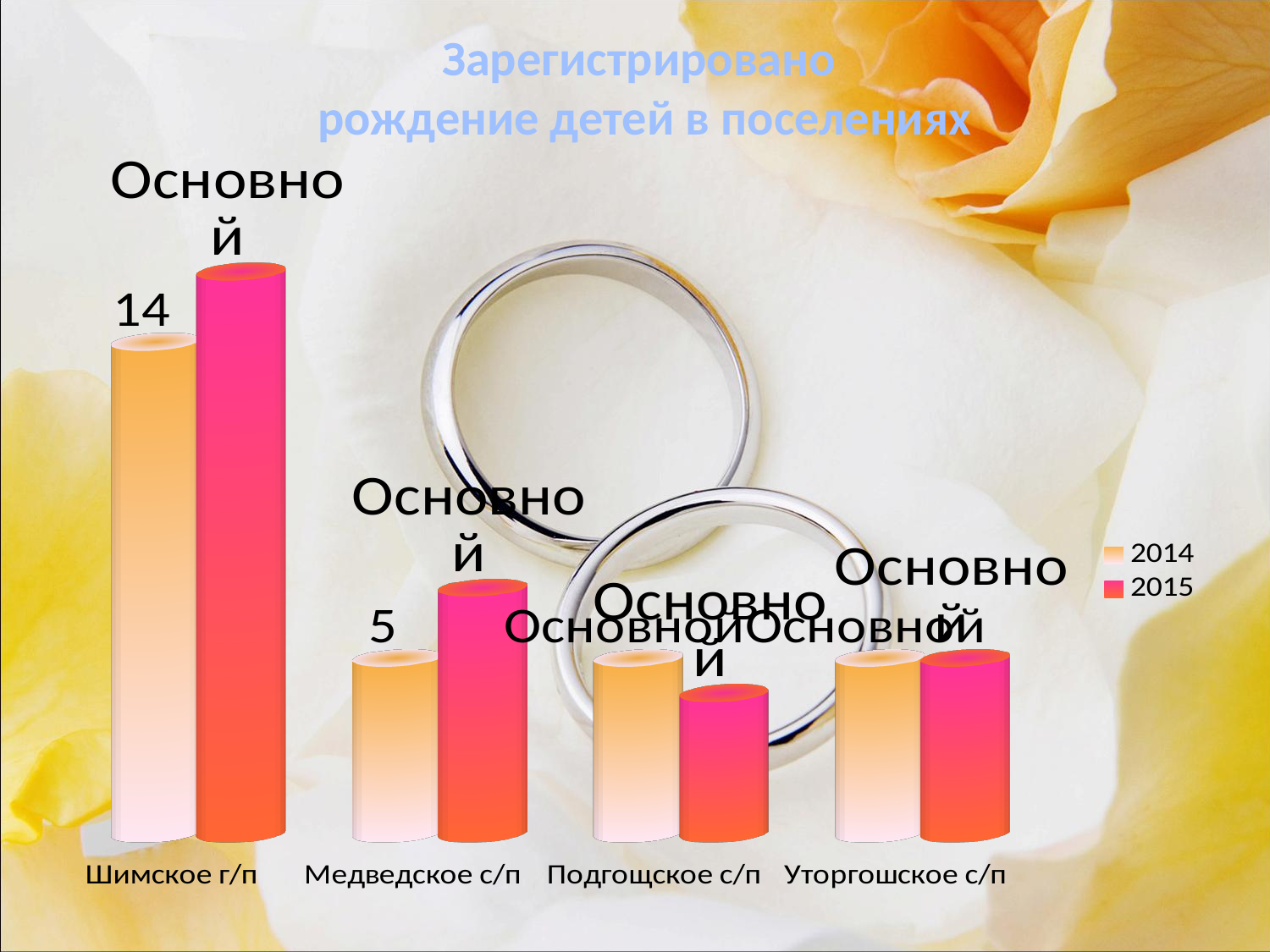
How many series does the legend list? 2 For Подгощское с/п, which year has the larger value, 2014 or 2015? 2014 What is the value for Шимское г/п in 2014? 14 For Шимское г/п, which year has the larger value, 2014 or 2015? 2015 Which settlement has the lowest value in 2015? Подгощское с/п What is the difference between the 2014 values for Шимское г/п and Медведское с/п? 9 What kind of chart is shown on the slide? Bar chart How many settlements are shown on the x axis? 4 Which settlement has the highest value in 2014? Шимское г/п What is the title of the chart? Зарегистрировано рождение детей в поселениях Which settlement has the highest value in 2015? Шимское г/п What is the value for Медведское с/п in 2014? 5